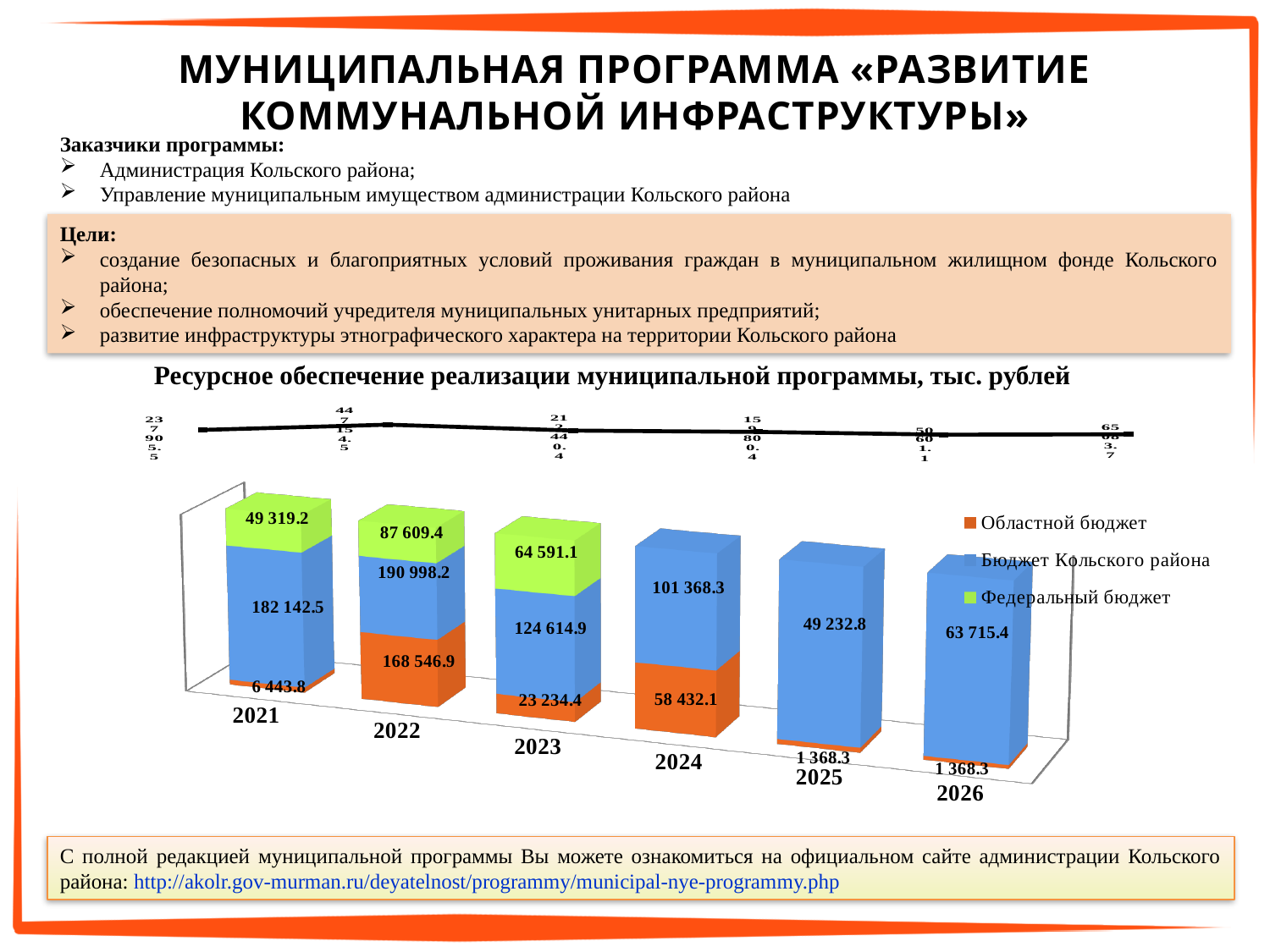
What is the value of Бюджет Кольского района for 2021? 182 142.5 Which is larger: Областной бюджет in 2024 or Областной бюджет in 2023? Областной бюджет in 2024 What kind of chart is used to show the resource provision of the programme? Stacked bar chart What is the difference between Бюджет Кольского района in 2022 and in 2023? 66 383.3 In which year is Бюджет Кольского района the lowest? 2025 How many years are shown on the x axis of the chart? 6 How many series does the legend list? 3 What is the value of Федеральный бюджет for 2023? 64 591.1 Which colour represents Федеральный бюджет in the legend? Green In which year is Федеральный бюджет the highest? 2022 What is the total of the stacked bar for 2024? 159 800.4 What is the value of Областной бюджет for 2022? 168 546.9